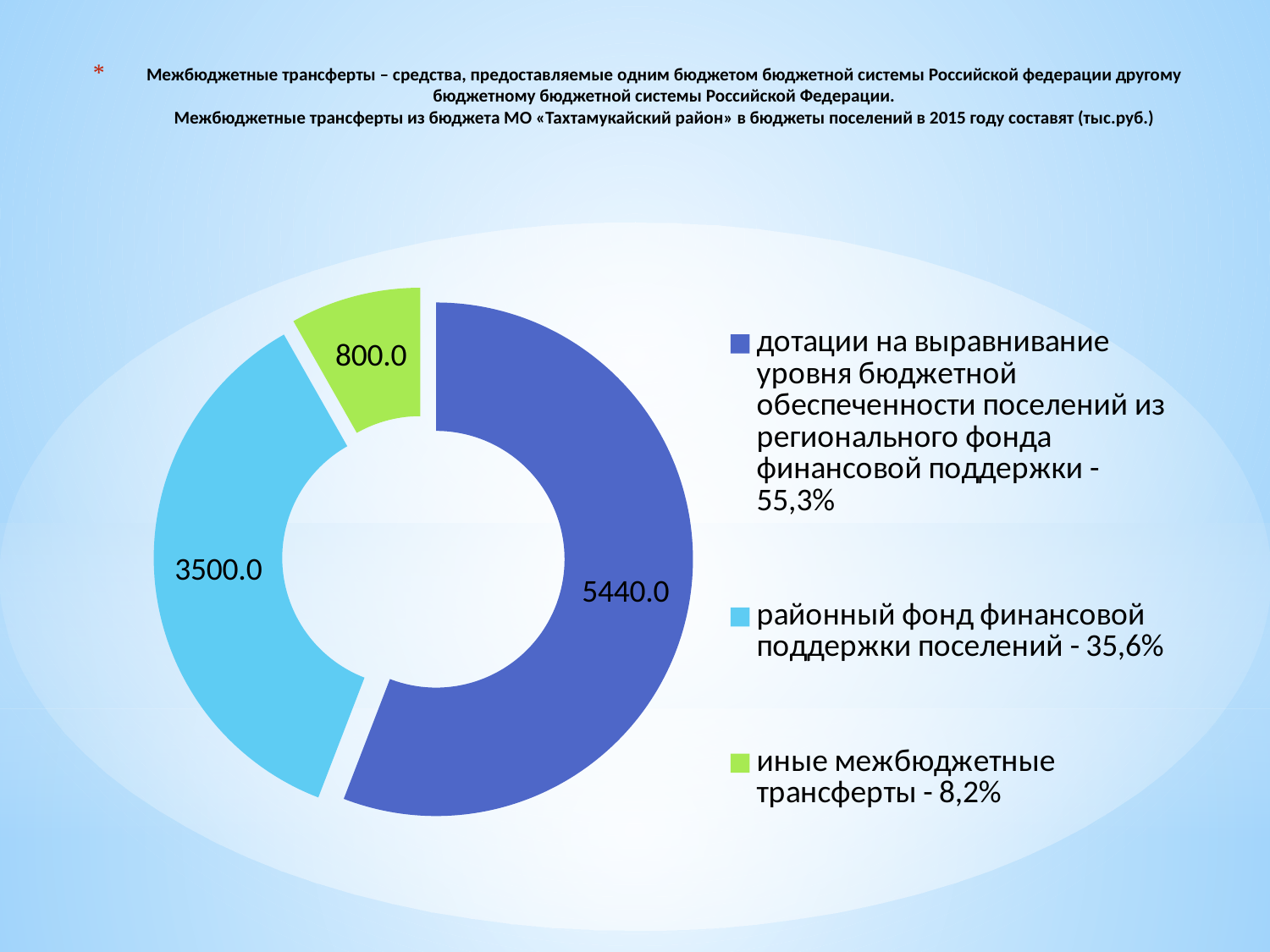
What is the difference between the value for «дотации на выравнивание...» (5440.0) and «районный фонд финансовой поддержки поселений» (3500.0)? 1940.0 How many slices does the chart have? 3 What is the value for «дотации на выравнивание уровня бюджетной обеспеченности поселений из регионального фонда финансовой поддержки»? 5440.0 What is the difference between the value for «районный фонд финансовой поддержки поселений» and «иные межбюджетные трансферты»? 2700.0 What share of the total does «районный фонд финансовой поддержки поселений» represent, according to the legend? 35,6% Which is larger: the value for «районный фонд финансовой поддержки поселений» or «иные межбюджетные трансферты»? районный фонд финансовой поддержки поселений What is the value for «районный фонд финансовой поддержки поселений»? 3500.0 Which category has the smallest slice? иные межбюджетные трансферты What is the value for «иные межбюджетные трансферты»? 800.0 Which category has the largest slice? дотации на выравнивание уровня бюджетной обеспеченности поселений из регионального фонда финансовой поддержки What kind of chart is shown on the slide? doughnut (pie) chart What is the total of all three slices? 9740.0